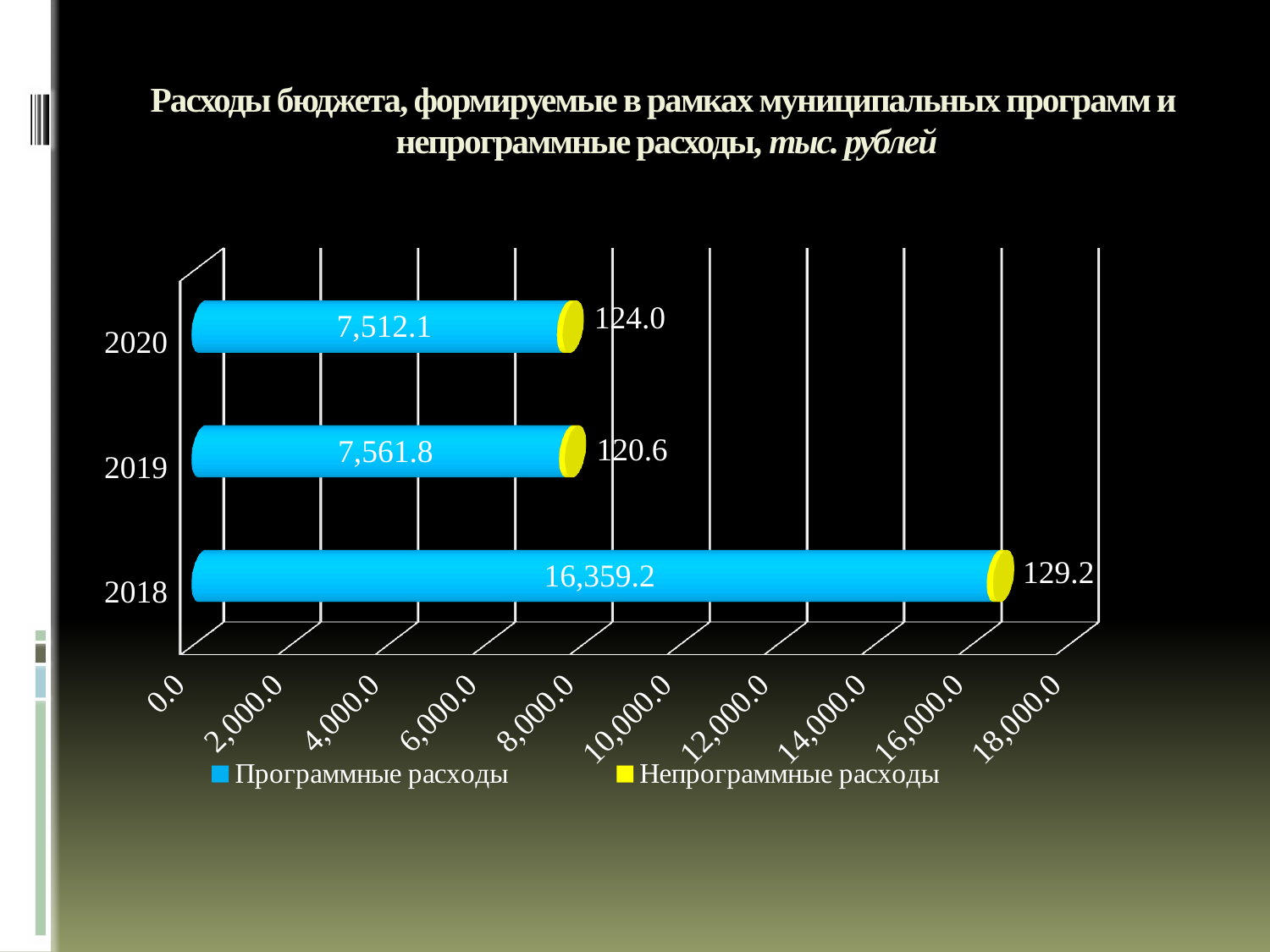
What is the difference between Непрограммные расходы in 2018 and 2019? 8.6 What is the value of Программные расходы for 2018? 16,359.2 What is the total of the stacked bar for 2020? 7,636.1 What is the value of Программные расходы for 2019? 7,561.8 What kind of chart is shown on the slide? Bar chart Which year has the lowest value of Непрограммные расходы? 2019 How many years are shown on the chart? 3 How many series does the legend list? 2 What is the value of Непрограммные расходы for 2020? 124.0 What is the difference between Программные расходы in 2018 and 2019? 8,797.4 Which is larger: Программные расходы in 2019 or in 2020? 2019 Which year has the highest value of Программные расходы? 2018